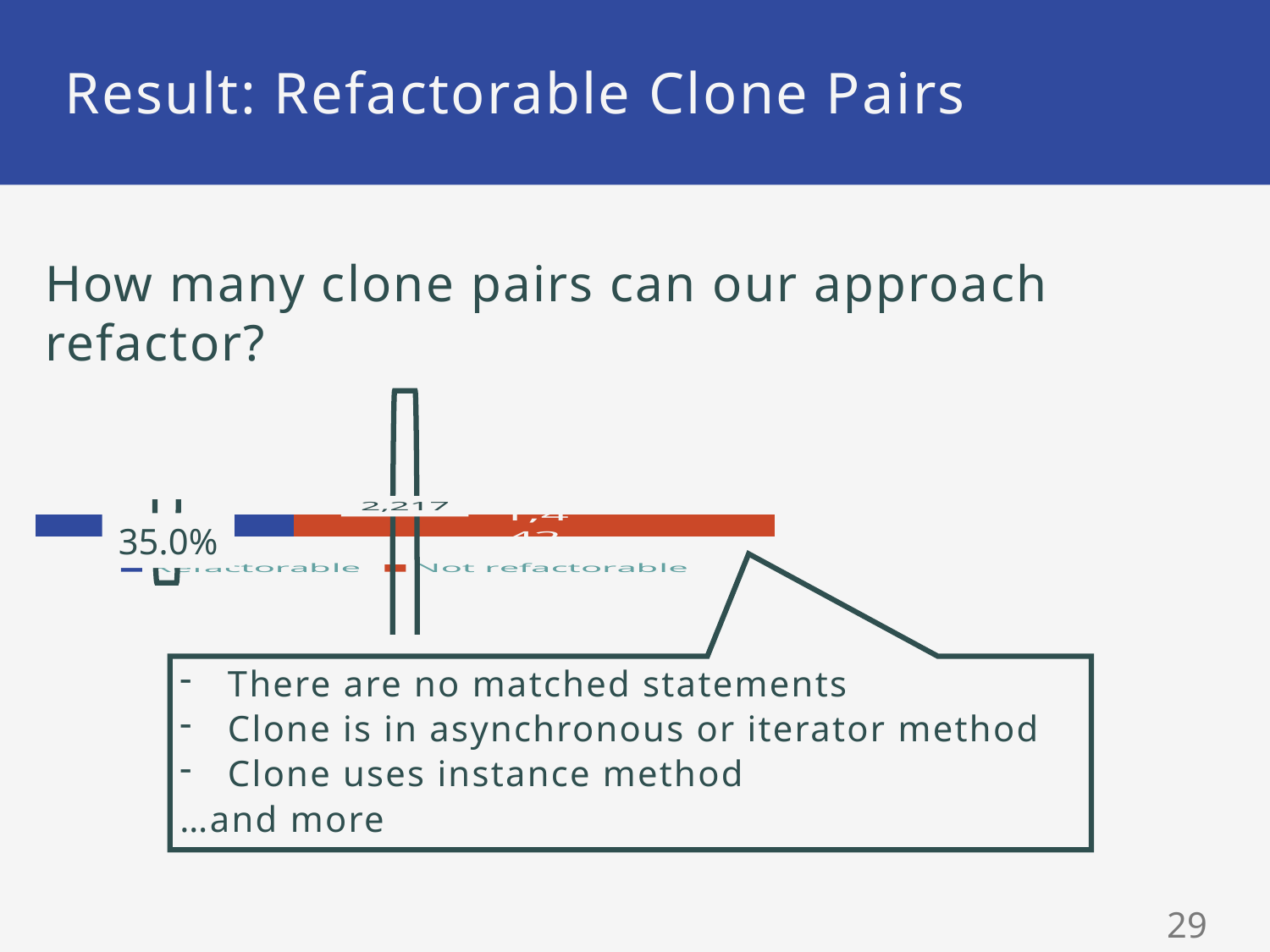
What colour represents the Refactorable series in the chart? blue Which segment of the bar is larger, Refactorable or Not refactorable? Not refactorable How many series does the chart's legend list? 2 What kind of chart is shown on the slide? bar chart What colour represents the Not refactorable series in the chart? red